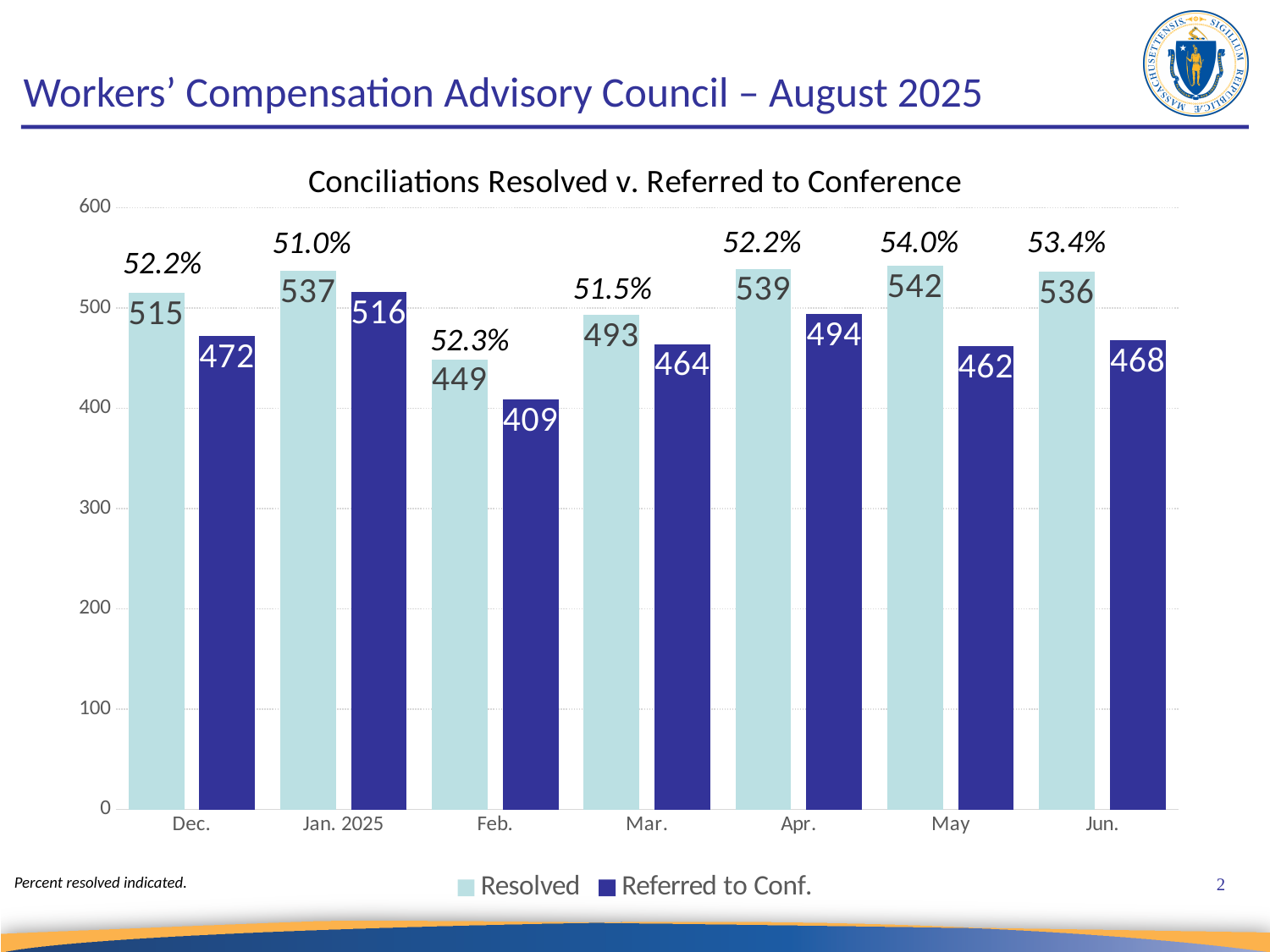
What is the Resolved value for Feb.? 449 Is the Referred to Conf. value for Feb. greater or less than 500? less What is the title of the chart? Conciliations Resolved v. Referred to Conference What is the Referred to Conf. value for Apr.? 494 Which is larger, the Referred to Conf. value for Jan. 2025 or for Jun.? Jan. 2025 What kind of chart is shown? bar chart How many series does the legend list? 2 What percent resolved is indicated for May? 54.0% Which month has the highest Resolved value? May How many months are shown on the x axis? 7 What is the difference between the Resolved and Referred to Conf. values for May? 80 Which month has the lowest Referred to Conf. value? Feb.